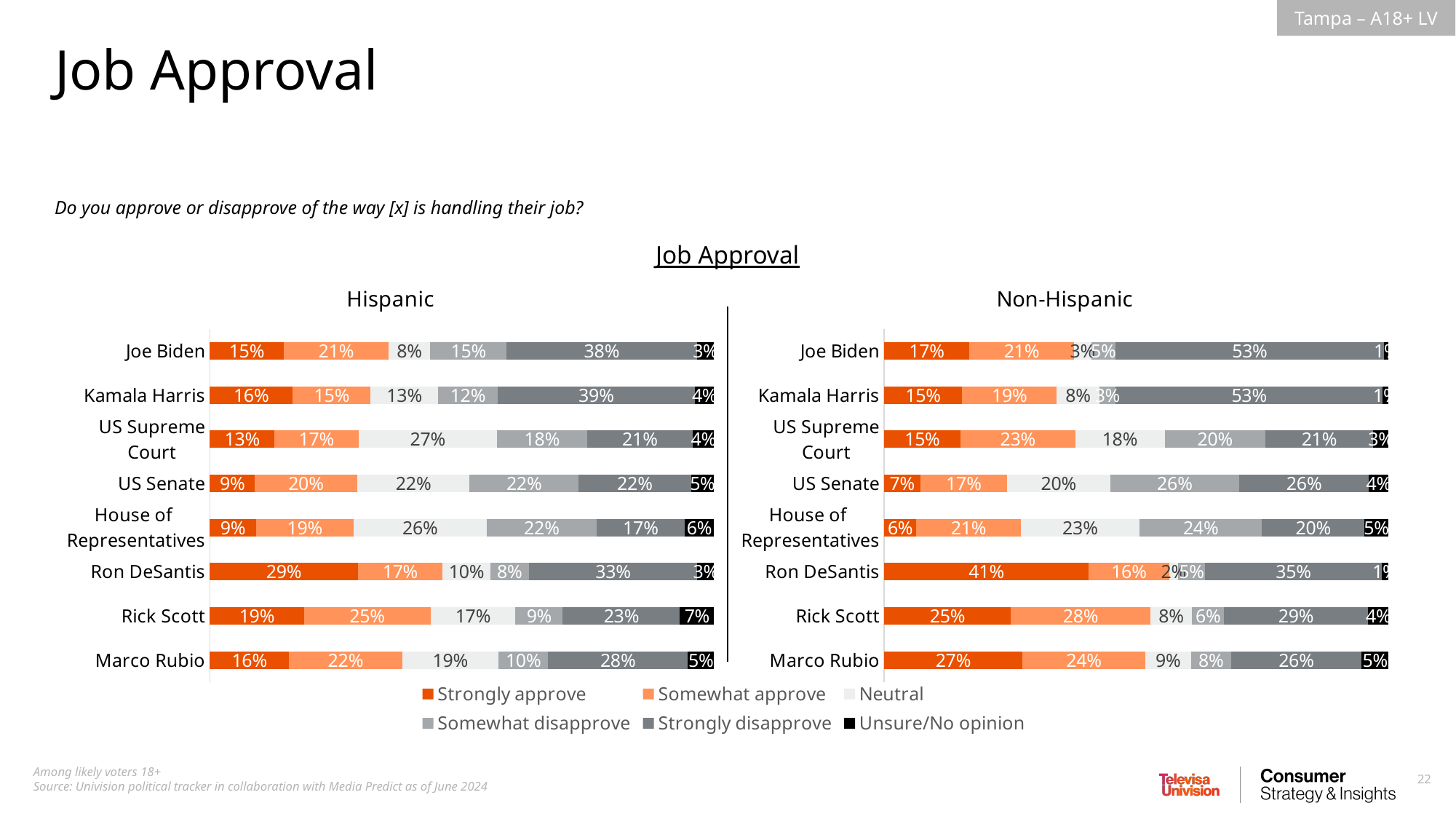
What type of chart is used for the Non-Hispanic data? Stacked bar chart In the Hispanic chart, what is the combined Strongly approve and Somewhat approve percentage for Rick Scott? 44% In the Hispanic chart, which category has the highest Strongly approve percentage? Ron DeSantis In the Hispanic chart, what percentage strongly disapprove of Joe Biden? 38% In the Hispanic chart, what is the difference between the Strongly disapprove percentages for Kamala Harris and Ron DeSantis? 6% In the Non-Hispanic chart, what percentage somewhat approve of Rick Scott? 28% How many series does the legend list? 6 In the Non-Hispanic chart, which category has the lowest Strongly approve percentage? House of Representatives How many categories are shown in the Hispanic chart? 8 In the Non-Hispanic chart, what percentage strongly approve of Ron DeSantis? 41% In the Non-Hispanic chart, is the Strongly approve percentage higher for Marco Rubio or Rick Scott? Marco Rubio In the Hispanic chart, what is the Neutral percentage for the US Supreme Court? 27%